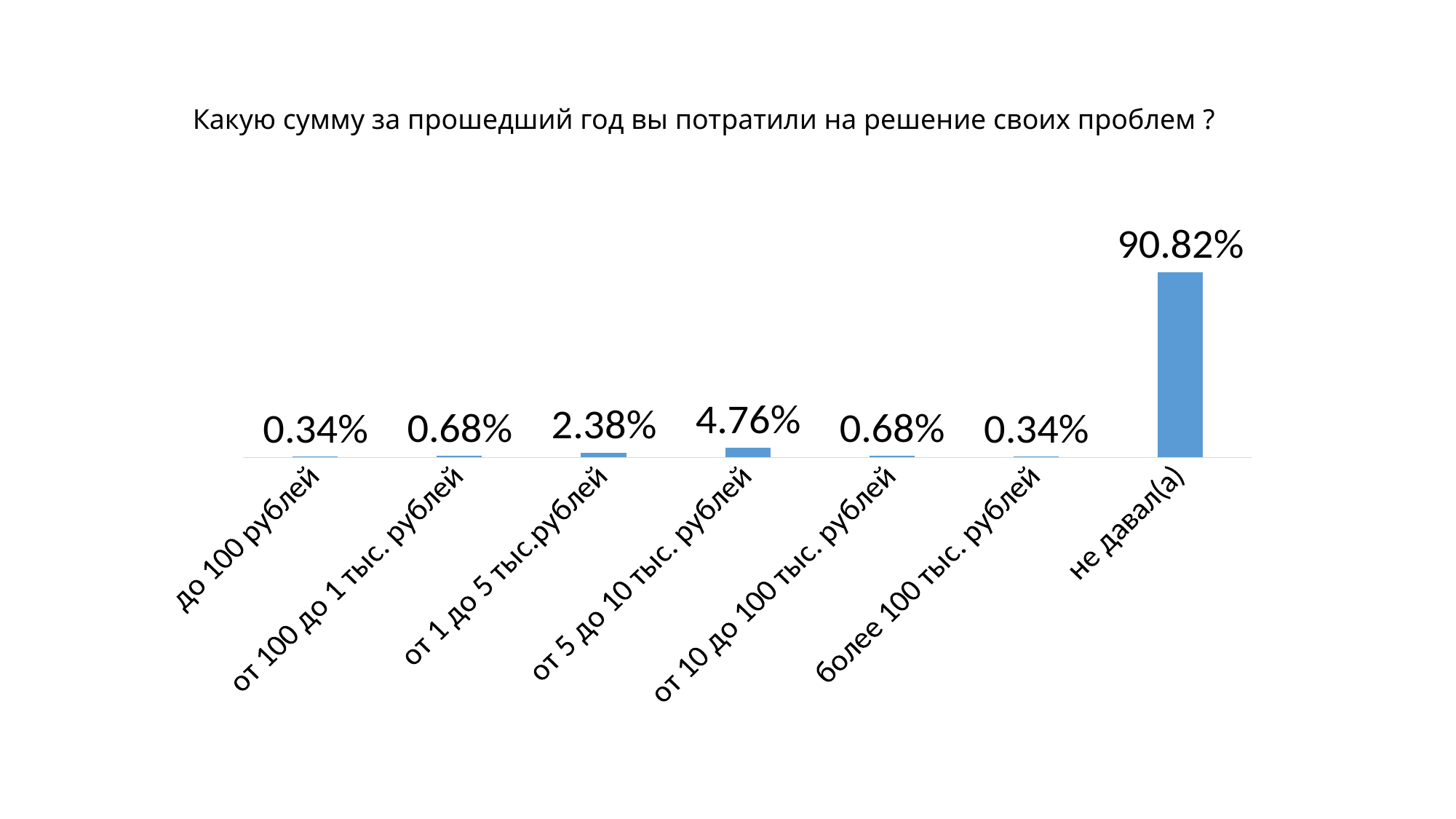
What is the difference between the values for "не давал(а)" and "от 5 до 10 тыс. рублей"? 86.06% What kind of chart is shown on the slide? bar chart What is the title of the chart? Какую сумму за прошедший год вы потратили на решение своих проблем ? What is the value for "от 10 до 100 тыс. рублей"? 0.68% Which is larger, the value for "от 100 до 1 тыс. рублей" or the value for "от 1 до 5 тыс.рублей"? от 1 до 5 тыс.рублей How many categories are shown in the chart? 7 What is the difference between the values for "от 5 до 10 тыс. рублей" and "от 1 до 5 тыс.рублей"? 2.38% What is the value for "до 100 рублей"? 0.34% Which category has the highest value? не давал(а) What is the value for "не давал(а)"? 90.82% What is the value for "от 5 до 10 тыс. рублей"? 4.76% What is the value for "от 1 до 5 тыс.рублей"? 2.38%